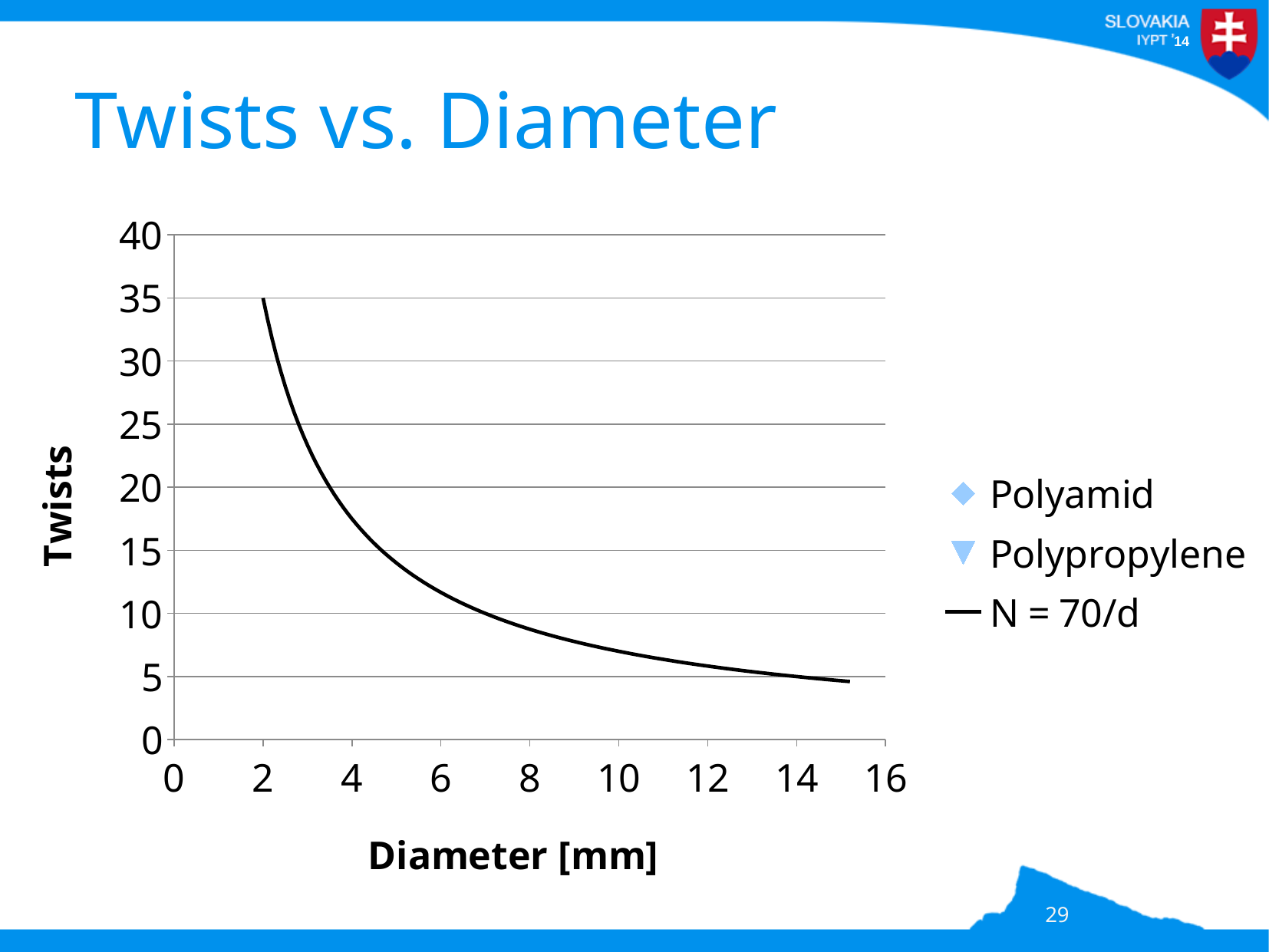
Is the value of the N = 70/d curve at a diameter of 6 mm greater or less than 15? less What is the label of the x axis? Diameter [mm] Is the value of the N = 70/d curve at a diameter of 3 mm greater or less than 20? greater Which is larger on the N = 70/d curve: the value at a diameter of 4 mm or at 8 mm? 4 mm Is the value of the N = 70/d curve at a diameter of 4 mm greater or less than 15? greater Do the values of the N = 70/d curve rise or fall as the diameter increases? fall What is the title of the chart? Twists vs. Diameter What kind of chart is shown on the slide? line chart What formula is given in the legend for the plotted curve? N = 70/d How many entries does the chart legend list? 3